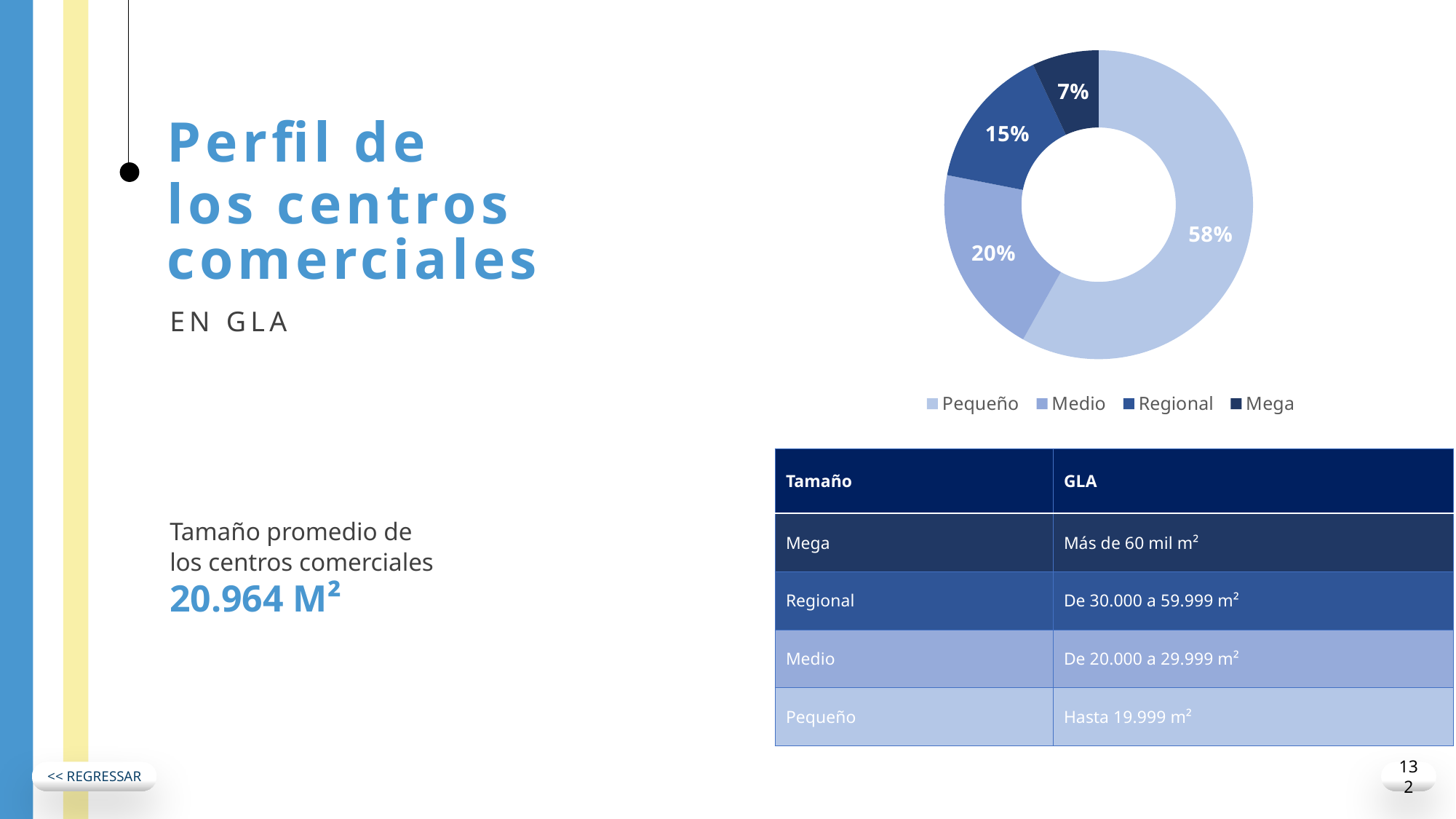
What percentage is shown for the Mega category in the doughnut chart? 7% Which category is listed first in the legend of the doughnut chart? Pequeño What share of the doughnut chart does the Pequeño category represent? 58% What percentage is shown for the Medio category in the doughnut chart? 20% What is the combined share of Regional and Mega in the doughnut chart? 22% What type of chart is shown on the slide? Doughnut chart Which category has the smallest share in the doughnut chart? Mega What percentage is shown for the Regional category in the doughnut chart? 15% How many categories are shown in the doughnut chart? 4 Which has a larger share in the doughnut chart, Regional or Mega? Regional Which category has the largest share in the doughnut chart? Pequeño What is the difference in percentage points between the Pequeño and Medio shares in the doughnut chart? 38